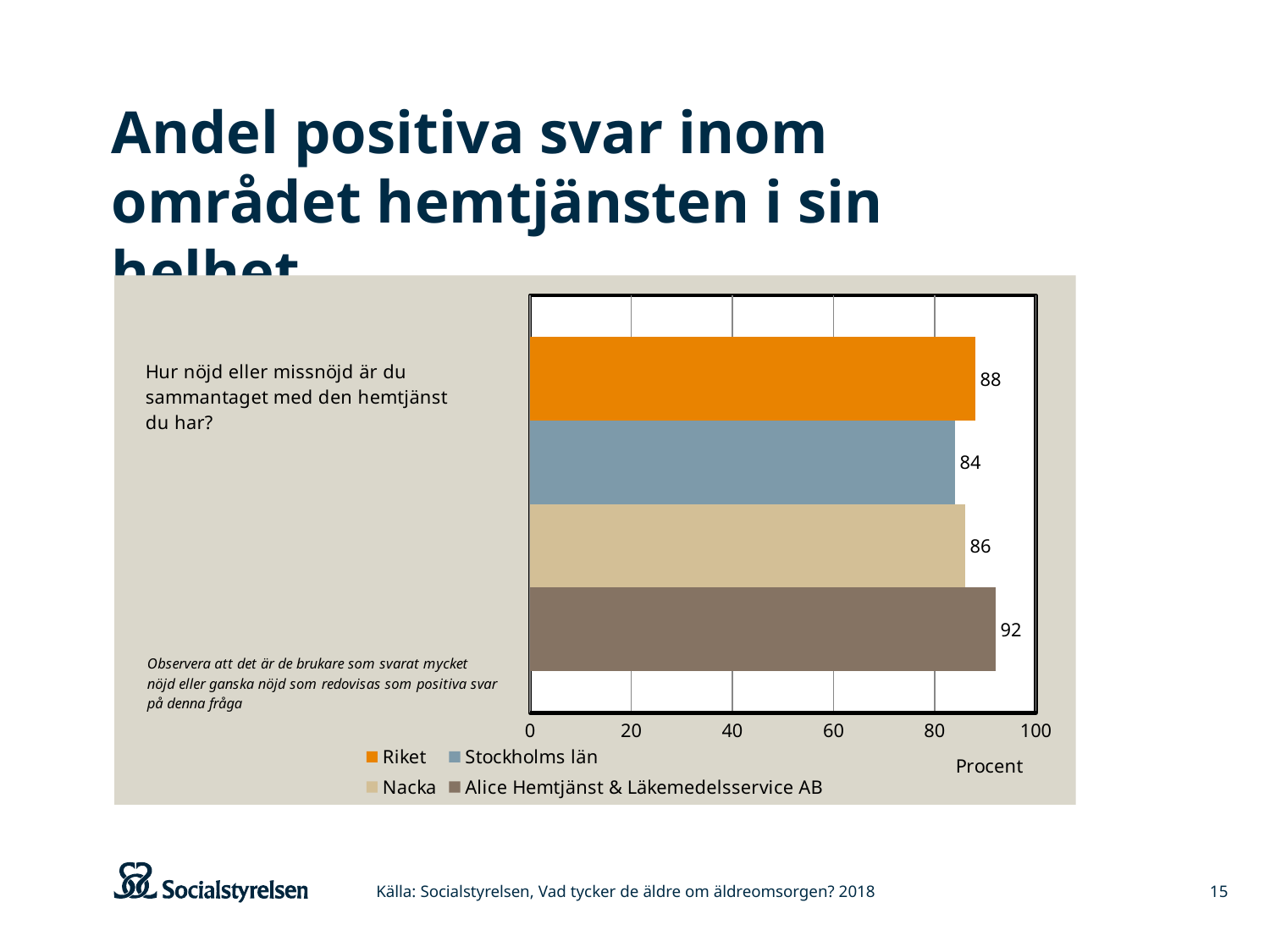
Which series has the highest value? Alice Hemtjänst & Läkemedelsservice AB What is the label of the horizontal axis? Procent What is the value for Nacka? 86 What is the difference between the values for Alice Hemtjänst & Läkemedelsservice AB and Stockholms län? 8 What kind of chart is shown on the slide? Bar chart What is the value for Stockholms län? 84 Which series has the lowest value? Stockholms län What is the value for Alice Hemtjänst & Läkemedelsservice AB? 92 What is the value for Riket? 88 How many series does the legend list? 4 Which is larger, the value for Riket or the value for Nacka? Riket What colour is the bar for Riket? Orange